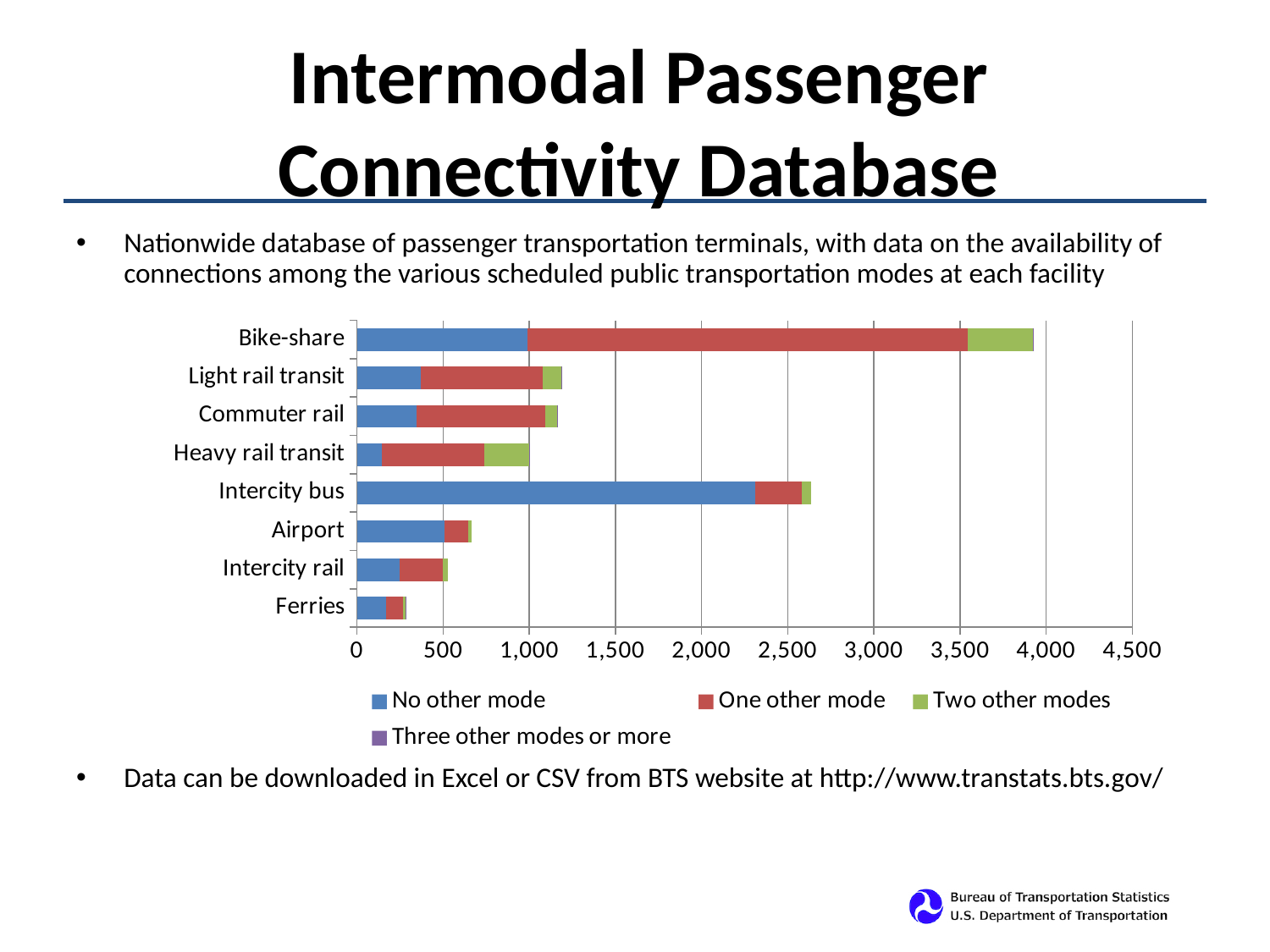
Which category has the longest total bar? Bike-share Is the total bar for Bike-share greater or less than 3,500? greater Which has a longer total bar, Airport or Ferries? Airport Is the 'No other mode' segment for Intercity bus greater or less than 2,000? greater How many categories are plotted on the chart? 8 Is the total bar for Light rail transit greater or less than 1,000? greater Which category has the shortest total bar? Ferries Which has a longer total bar, Intercity bus or Heavy rail transit? Intercity bus Which legend entry is shown in red? One other mode What kind of chart is shown on the slide? Stacked bar chart How many series does the chart's legend list? 4